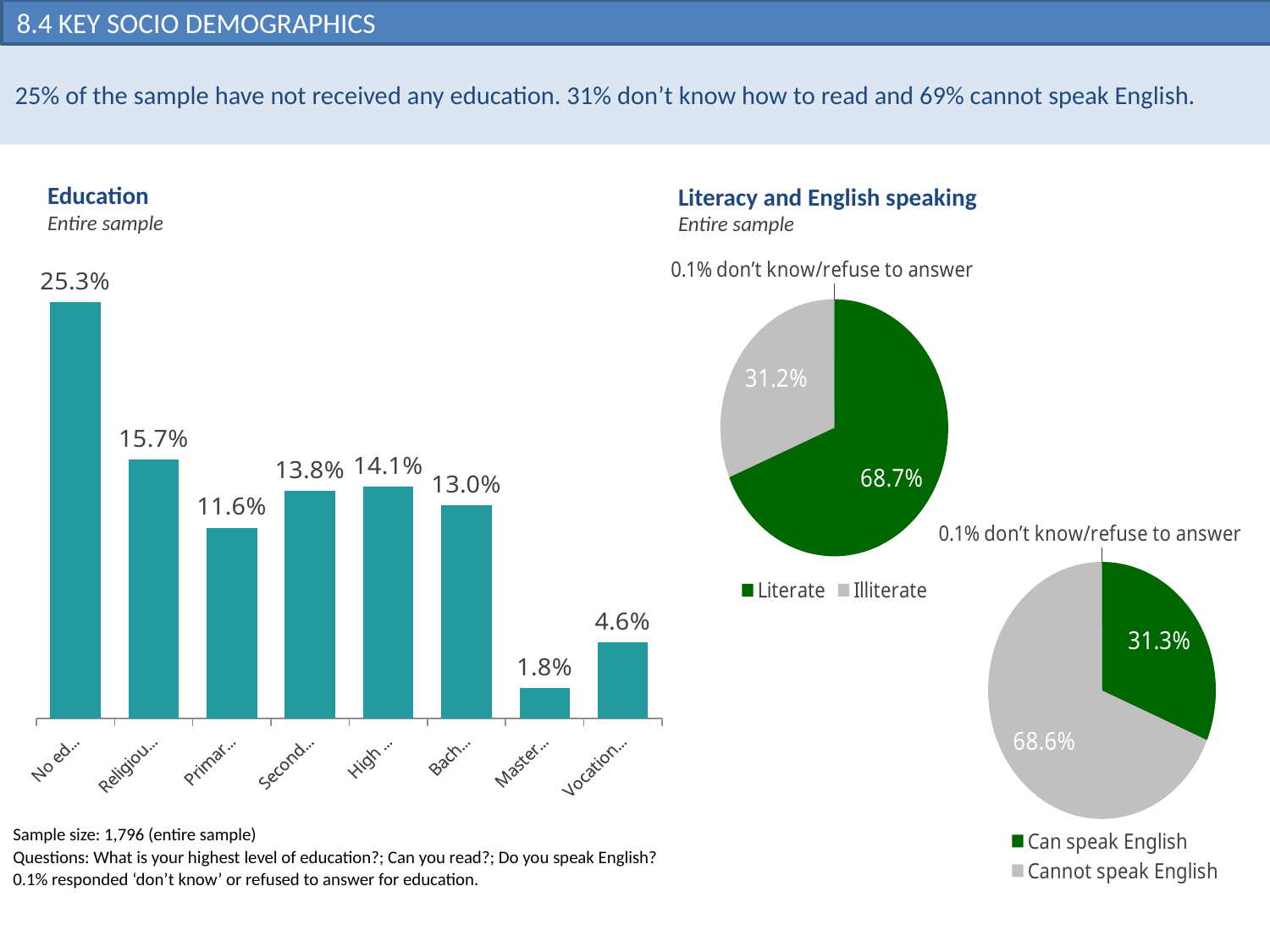
In the Education bar chart, what is the difference between the first (leftmost) bar and the second bar? 9.6% In the Education bar chart, what is the value of the tallest bar? 25.3% In the English speaking pie chart (bottom right), which slice is larger: Can speak English or Cannot speak English? Cannot speak English In the Literacy pie chart (top right), what share of the sample is Illiterate? 31.2% In the Literacy pie chart (top right), what percentage of respondents answered don't know or refused to answer? 0.1% In the Literacy pie chart (top right), what is the difference between the Literate and Illiterate shares? 37.5% How many bars are shown in the Education bar chart? 8 In the Education bar chart, what is the value of the shortest bar? 1.8% In the Literacy pie chart (top right), what share of the sample is Literate? 68.7% In the English speaking pie chart (bottom right), what share of the sample can speak English? 31.3% What type of chart is the Education chart on the left? Bar chart